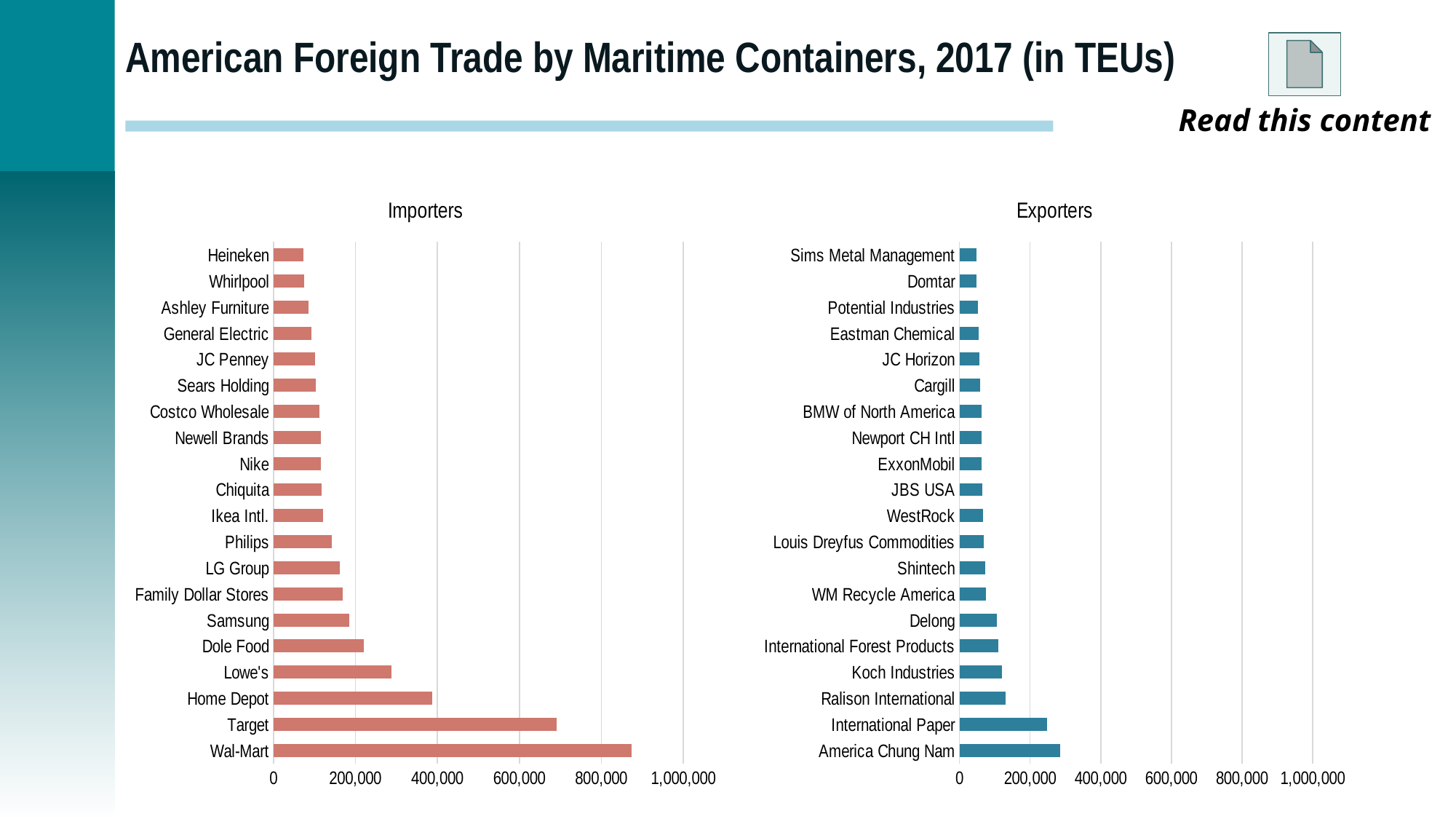
In the Importers chart, which company has the lowest value? Heineken In the Importers chart, is the value for Wal-Mart greater or less than 800,000? greater In the Importers chart, which is larger, the value for Home Depot or the value for Lowe's? Home Depot How many companies are shown in the Importers chart? 20 What kind of chart is the Exporters chart? bar chart In the Exporters chart, which is larger, the value for America Chung Nam or the value for Ralison International? America Chung Nam In the Importers chart, is the value for Target greater or less than 600,000? greater In the Importers chart, which company has the highest value? Wal-Mart In the Exporters chart, which company has the highest value? America Chung Nam What is the title of the slide? American Foreign Trade by Maritime Containers, 2017 (in TEUs) In the Exporters chart, is the value for Koch Industries greater or less than 200,000? less In the Exporters chart, which company has the lowest value? Sims Metal Management